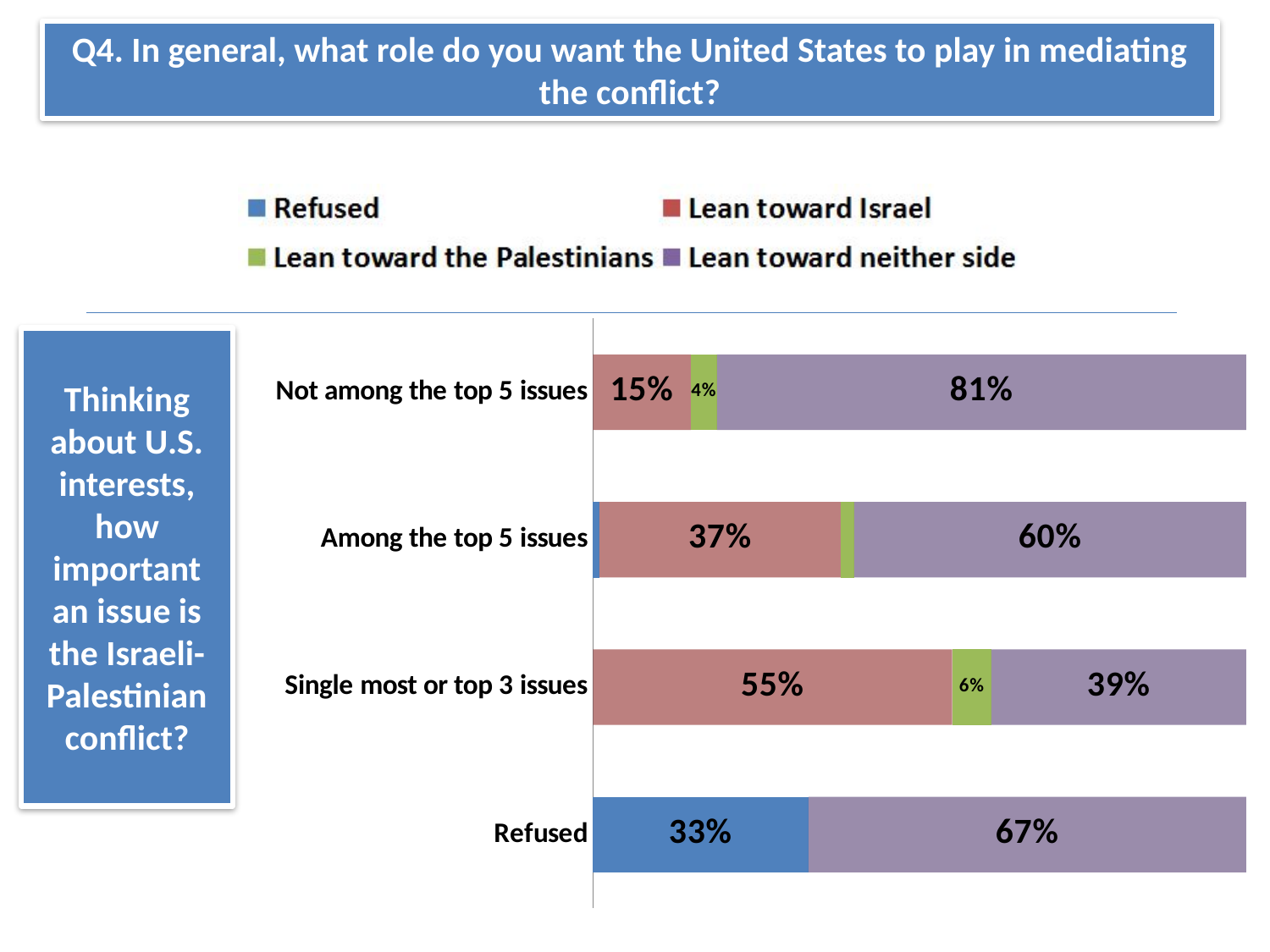
Is the 'Lean toward Israel' value larger for 'Single most or top 3 issues' or for 'Among the top 5 issues'? Single most or top 3 issues How many categories (rows) are shown in the chart? 4 What percentage of respondents who said the conflict is 'Not among the top 5 issues' want the U.S. to lean toward neither side? 81% What kind of chart is shown on the slide? Stacked bar chart How many series does the legend list? 4 What is the 'Lean toward the Palestinians' value for the 'Single most or top 3 issues' group? 6% Which group has the lowest 'Lean toward Israel' value among the three labelled groups? Not among the top 5 issues Which group has the highest 'Lean toward neither side' value? Not among the top 5 issues What is the 'Refused' value in the 'Refused' row? 33% What is the difference between the 'Lean toward neither side' value and the 'Lean toward Israel' value for the 'Not among the top 5 issues' group? 66 percentage points What is the 'Lean toward Israel' value for the 'Single most or top 3 issues' group? 55% What is the 'Lean toward neither side' value for the 'Among the top 5 issues' group? 60%